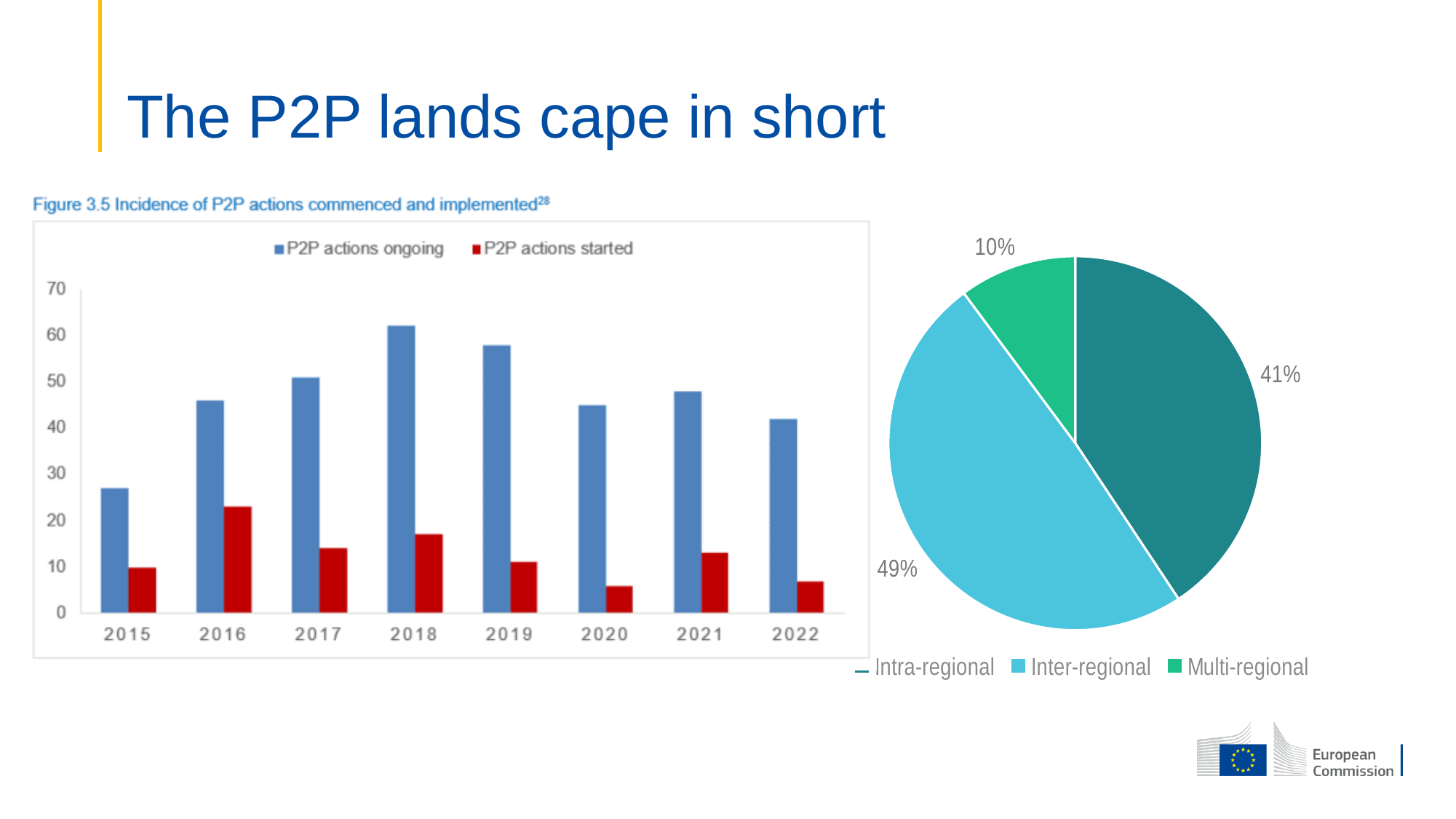
In Figure 3.5, which year has the highest value for P2P actions ongoing? 2018 In Figure 3.5, is the value for P2P actions ongoing in 2015 greater or less than 30? less In the pie chart on the right, what share is Intra-regional? 41% In Figure 3.5, which year has the lowest value for P2P actions ongoing? 2015 In the pie chart on the right, which category has the largest share? Inter-regional In the pie chart on the right, what share is Inter-regional? 49% In the pie chart on the right, what is the difference between the Inter-regional and Intra-regional shares? 8% In the pie chart on the right, what share is Multi-regional? 10% In Figure 3.5, which year has the highest value for P2P actions started? 2016 In the pie chart on the right, how many slices are there? 3 In the pie chart on the right, which category has the smallest share? Multi-regional In Figure 3.5, how many series does the legend list? 2